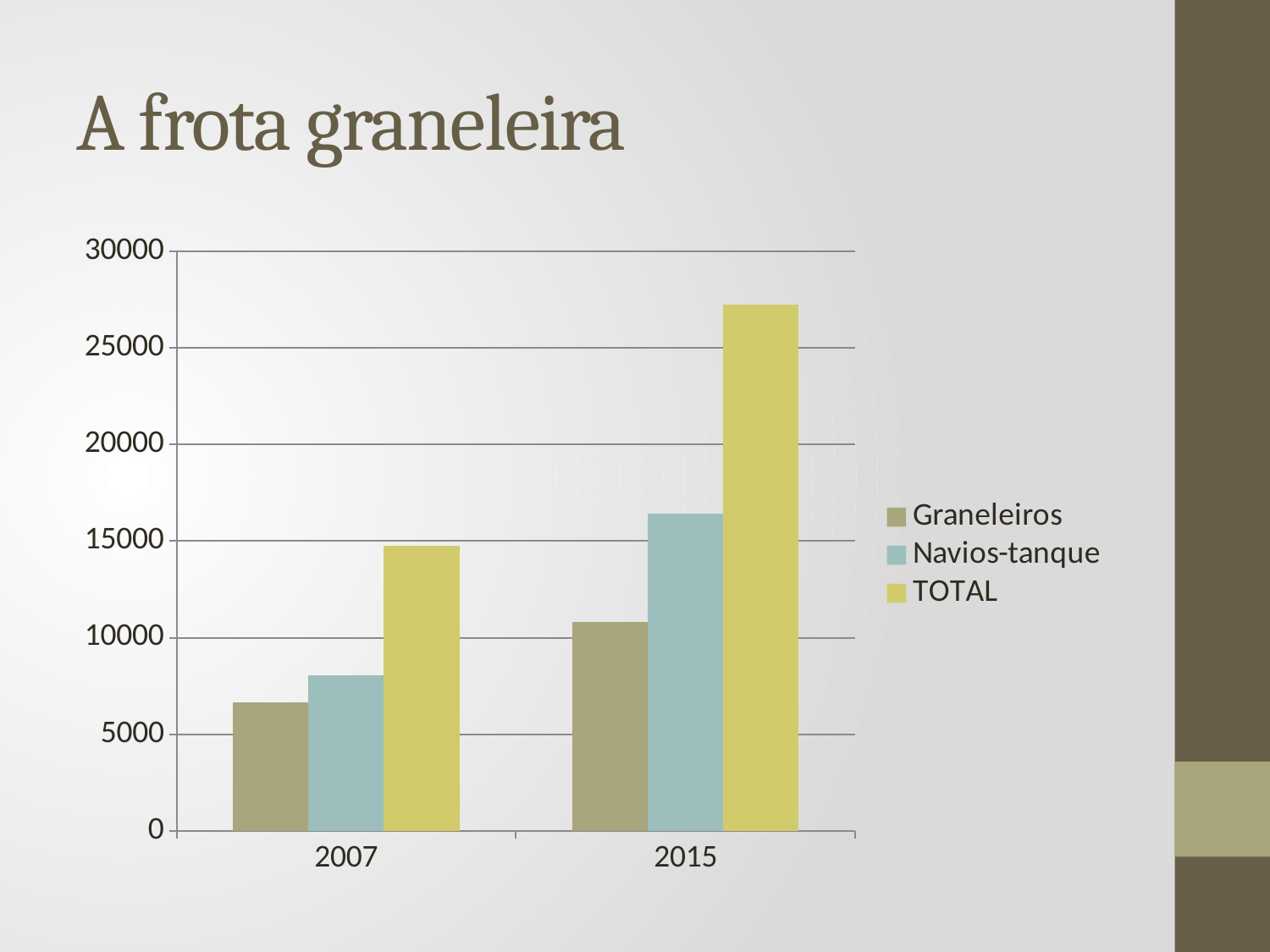
Which series has the tallest bar in 2015? TOTAL Is the value for Graneleiros in 2007 greater or less than 10000? less How many series does the legend list? 3 Which is larger, Navios-tanque in 2007 or Graneleiros in 2015? Graneleiros in 2015 Which series has the shortest bar in 2007? Graneleiros Is the value for TOTAL in 2015 greater or less than 25000? greater How many categories are shown on the x axis? 2 What is the title of the slide containing the chart? A frota graneleira What kind of chart is shown on the slide? bar chart Is the value for Navios-tanque in 2015 greater or less than 15000? greater Do the values for Graneleiros rise or fall from 2007 to 2015? rise